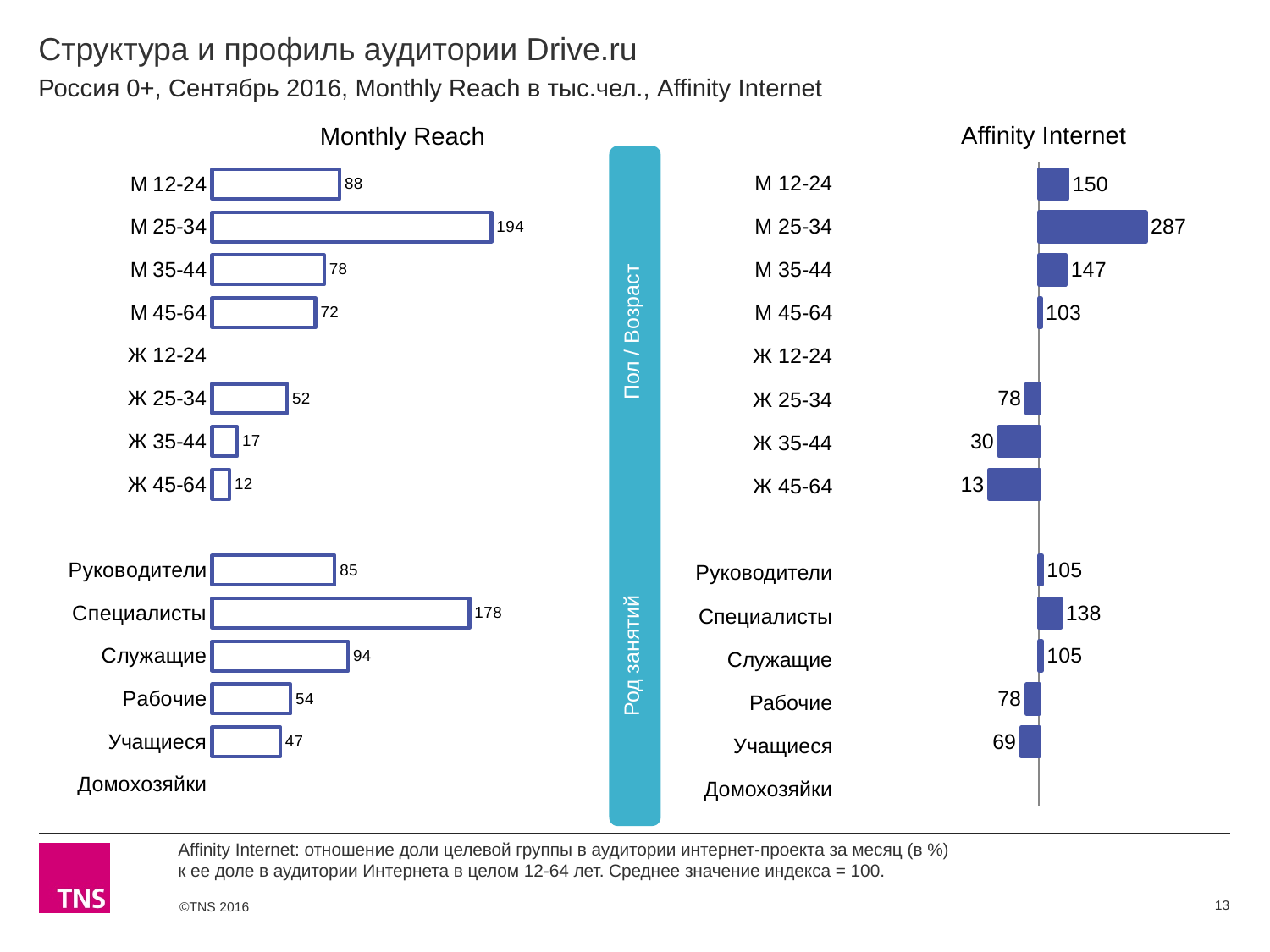
In the Monthly Reach chart, which is larger: Служащие or Руководители? Служащие In the Affinity Internet chart, what is the difference between М 12-24 and Ж 25-34? 72 In the Monthly Reach chart, what is the value for М 25-34? 194 In the Affinity Internet chart, which is larger: Рабочие or Учащиеся? Рабочие In the Affinity Internet chart, which occupation group has the highest value? Специалисты What type of chart is the Monthly Reach chart? Bar chart In the Monthly Reach chart, what is the value for Специалисты? 178 In the Monthly Reach chart, what is the difference between М 12-24 and М 35-44? 10 In the Monthly Reach chart, which labelled gender/age group has the lowest value? Ж 45-64 In the Monthly Reach chart, which gender/age group has the highest value? М 25-34 In the Affinity Internet chart, what is the value for Ж 45-64? 13 In the Affinity Internet chart, what is the value for М 25-34? 287